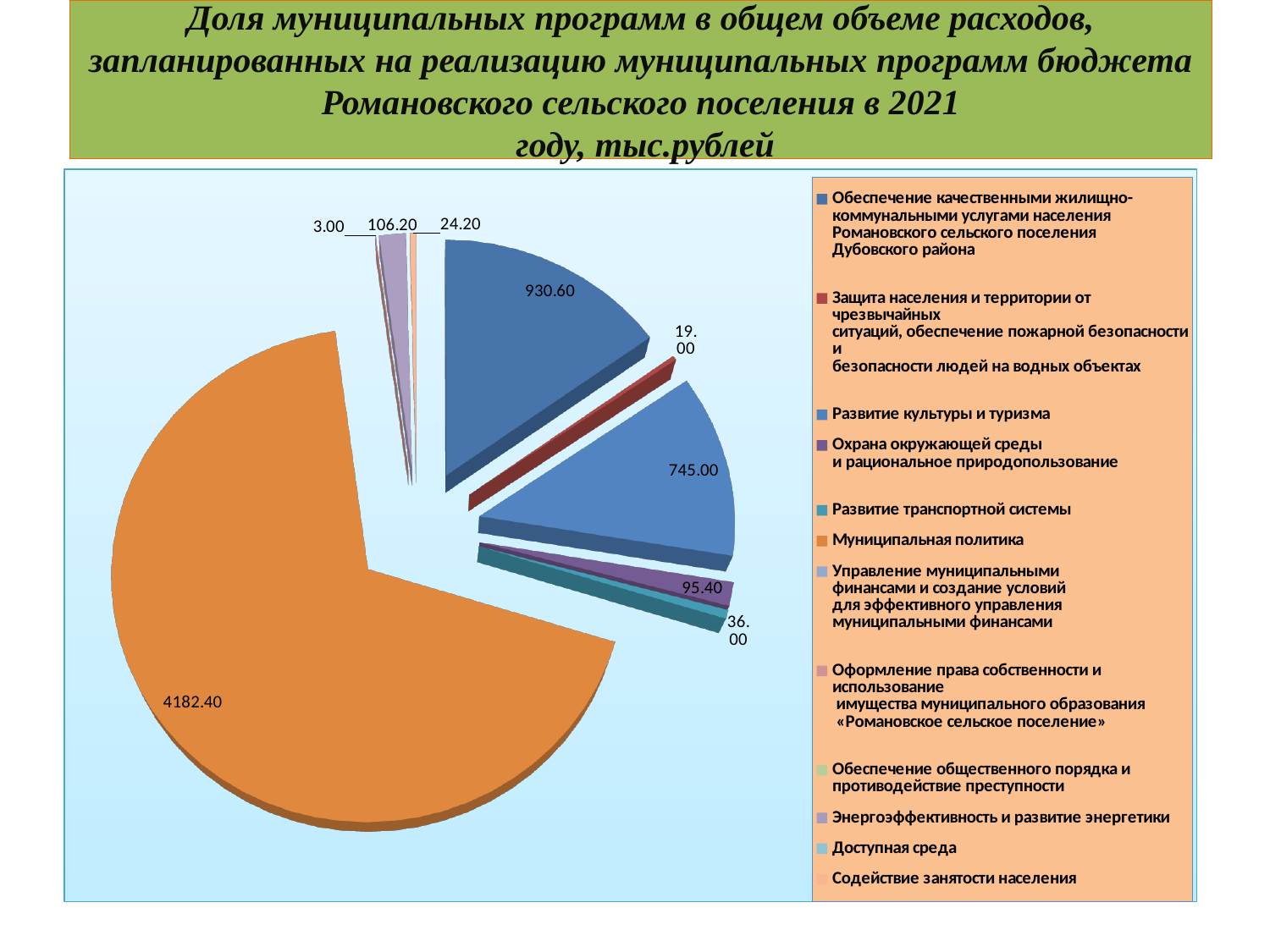
What is the value for Муниципальная политика? 4182.40 What is the value for Охрана окружающей среды и рациональное природопользование? 95.40 Which is larger: the value for Развитие культуры и туризма or the value for Обеспечение качественными жилищно-коммунальными услугами? Обеспечение качественными жилищно-коммунальными услугами What is the value for Обеспечение качественными жилищно-коммунальными услугами населения Романовского сельского поселения Дубовского района? 930.60 How many entries does the legend list? 12 What is the value for Развитие транспортной системы? 36.00 What colour is the slice for Муниципальная политика? orange What is the value for Защита населения и территории от чрезвычайных ситуаций, обеспечение пожарной безопасности и безопасности людей на водных объектах? 19.00 What kind of chart is shown on the slide? pie chart What is the value for Развитие культуры и туризма? 745.00 Which category has the largest slice of the pie? Муниципальная политика What is the difference between the values for Обеспечение качественными жилищно-коммунальными услугами and Развитие культуры и туризма? 185.60